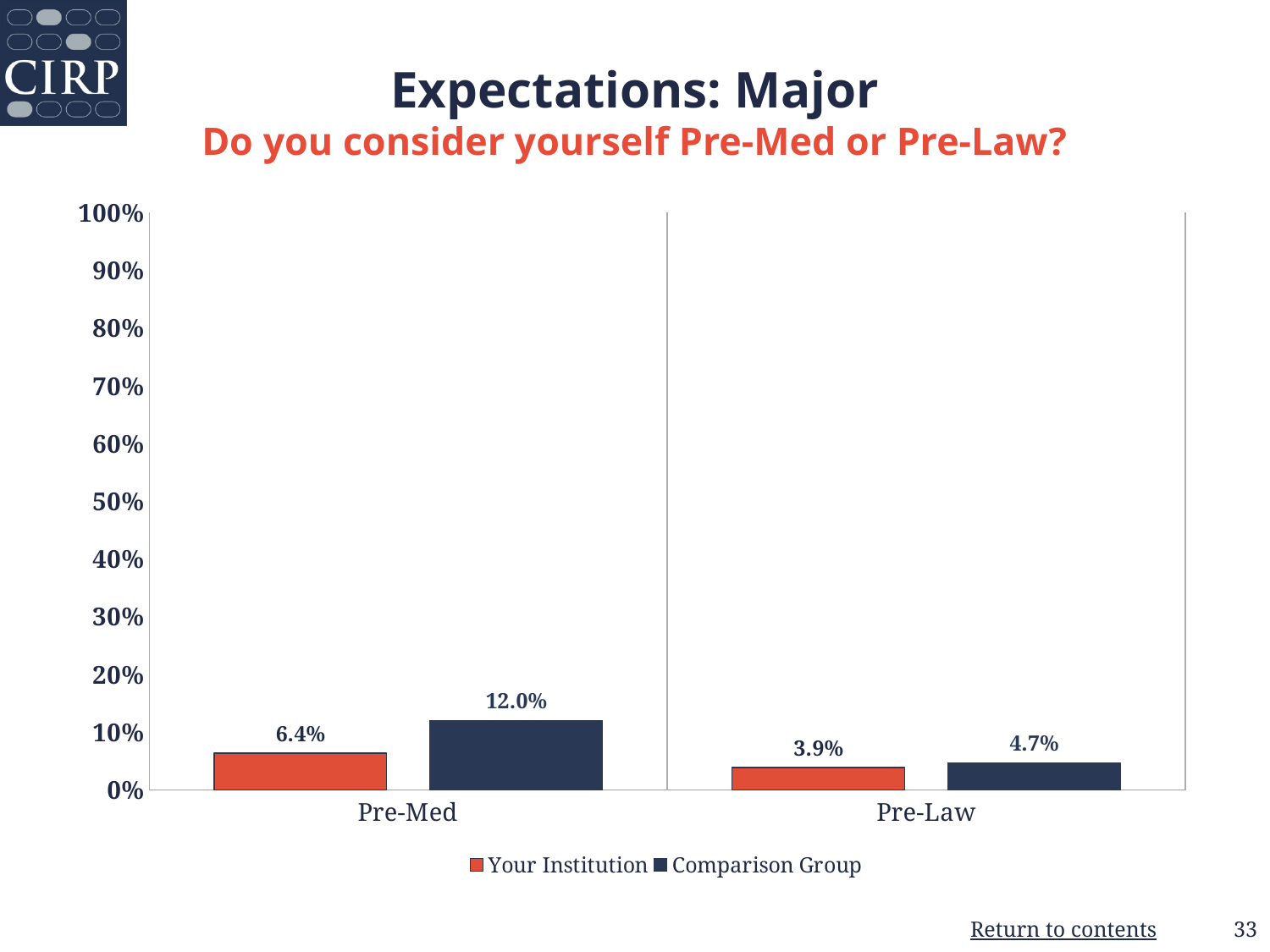
Is the Comparison Group value for Pre-Med greater or less than 10%? greater How many series does the legend list? 2 What is the value for Your Institution in the Pre-Med category? 6.4% How many categories are shown on the x axis? 2 What is the value for Comparison Group in the Pre-Med category? 12.0% What kind of chart is shown on the slide? Bar chart Which bar has the lowest value on the chart? Your Institution, Pre-Law What is the value for Comparison Group in the Pre-Law category? 4.7% Which bar has the highest value on the chart? Comparison Group, Pre-Med What is the difference between the Comparison Group and Your Institution values for Pre-Med? 5.6% Which is larger for Pre-Law: Your Institution or Comparison Group? Comparison Group What is the value for Your Institution in the Pre-Law category? 3.9%